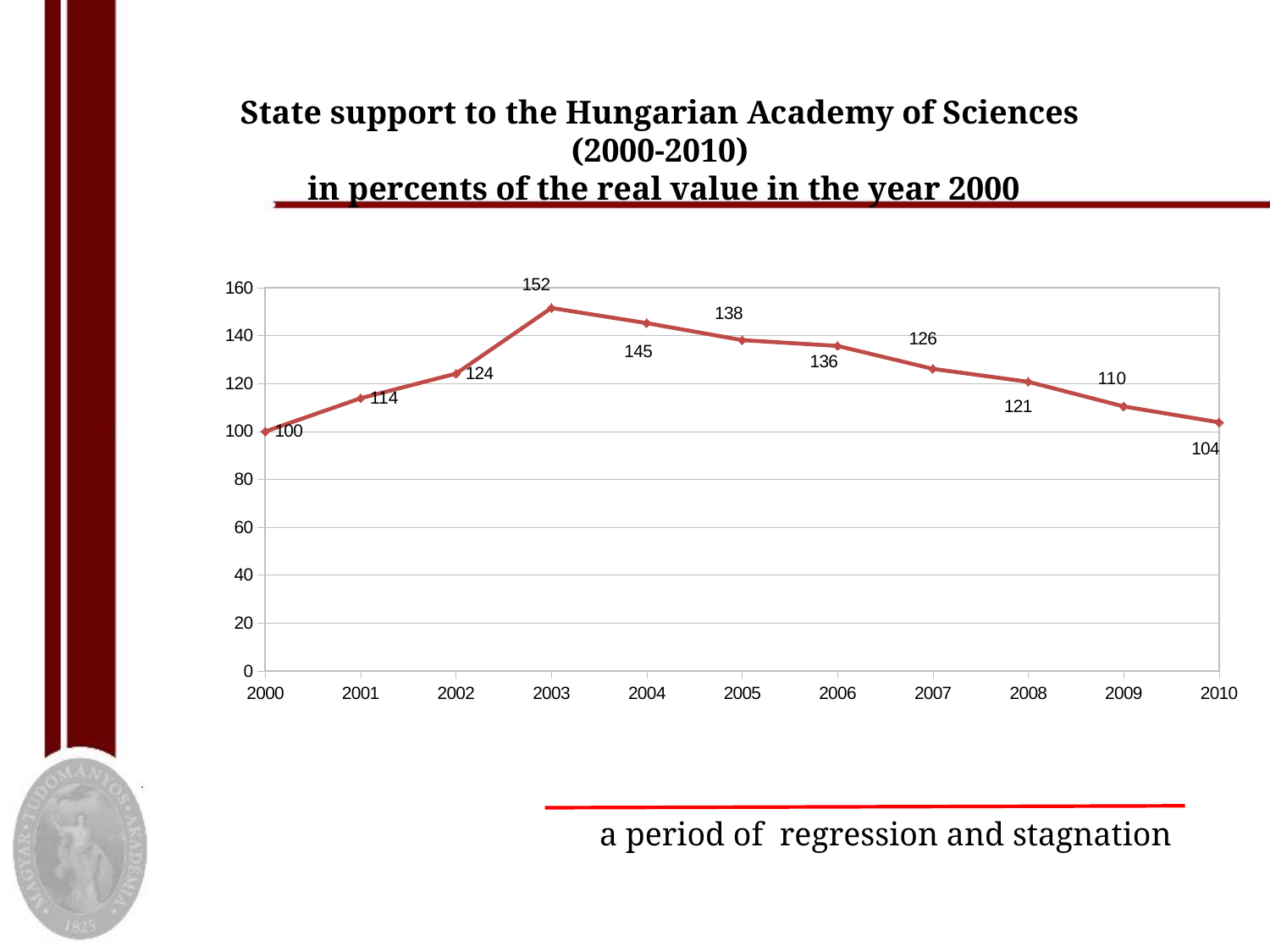
Is the value for 2004 greater or less than 140? greater What is the value for 2010? 104 Which is larger, the value for 2002 or the value for 2008? 2002 Which year has the highest value? 2003 What is the difference between the values for 2001 and 2000? 14 What is the value for 2003? 152 What is the value for 2006? 136 Which year has the lowest value? 2000 How many years are plotted on the x axis? 11 What kind of chart is shown? line chart Do the values rise or fall from 2003 to 2010? fall What is the difference between the values for 2003 and 2010? 48